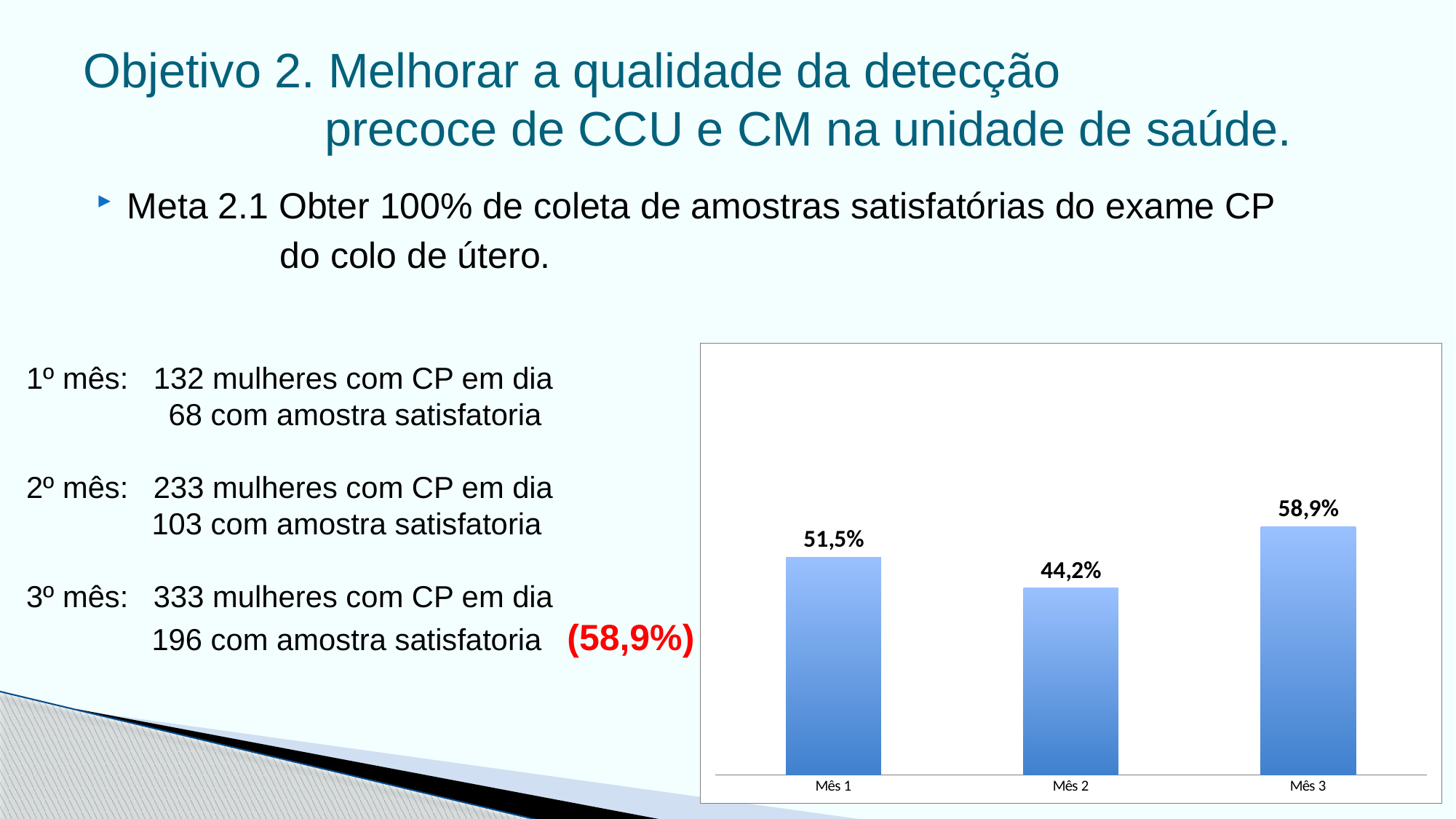
What kind of chart is shown on the slide? Bar chart Which month has the highest value? Mês 3 Which month has the lowest value? Mês 2 What is the value for Mês 2? 44,2% Which is larger, the value for Mês 1 or Mês 2? Mês 1 What is the value for Mês 1? 51,5% Which is larger, the value for Mês 3 or Mês 1? Mês 3 What is the value for Mês 3? 58,9% What is the difference between the values for Mês 1 and Mês 2? 7,3% How many months are shown on the chart? 3 What is the difference between the values for Mês 3 and Mês 2? 14,7% Does the value rise or fall from Mês 2 to Mês 3? Rise